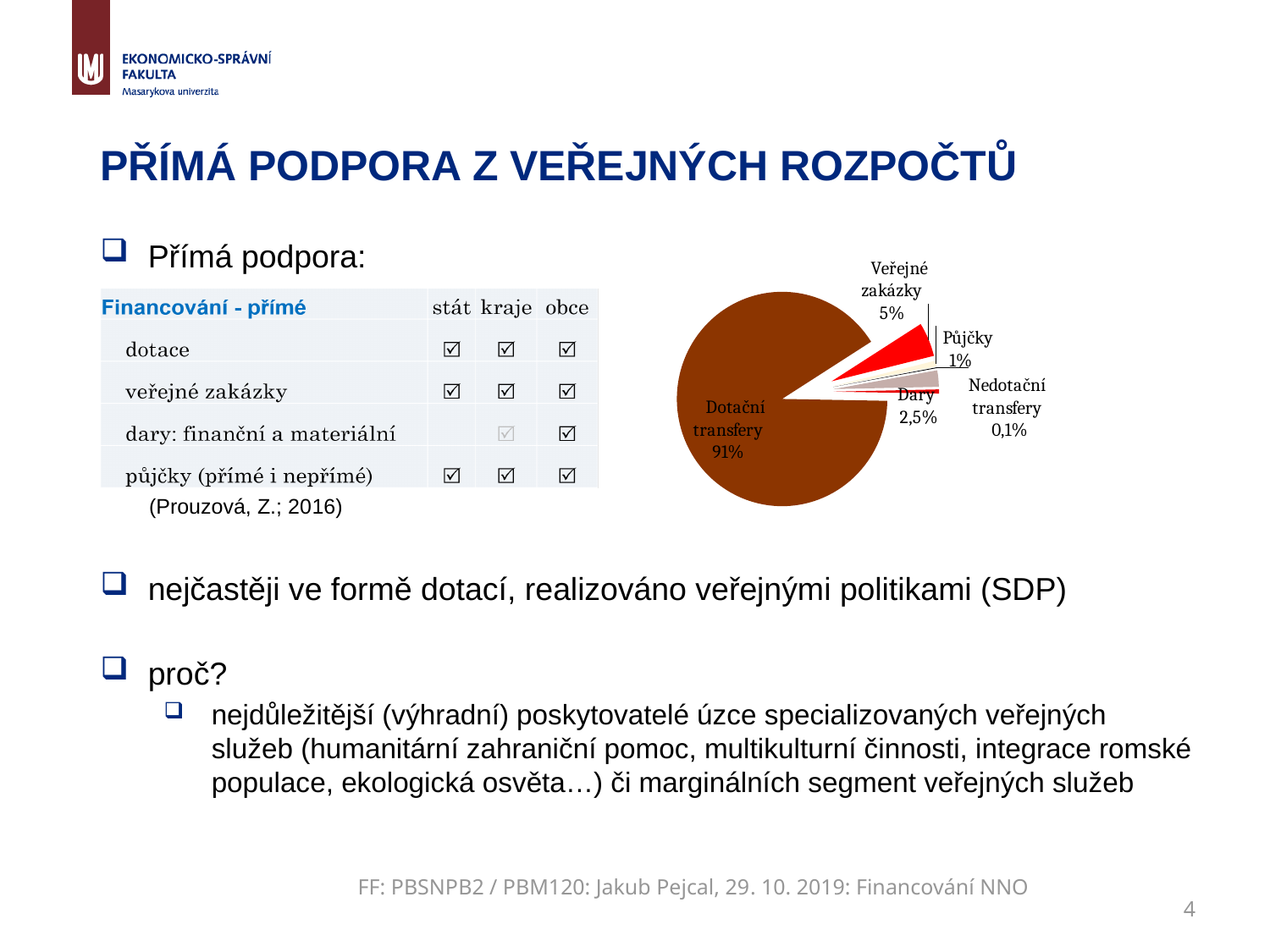
What share of the pie does Veřejné zakázky have? 5% What is the value shown for Půjčky in the pie chart? 1% What is the value shown for Nedotační transfery in the pie chart? 0,1% How many slices does the pie chart have? 6 Which slice of the pie chart is the smallest? Nedotační transfery What colour is the Dotační transfery slice in the pie chart? brown Which slice of the pie chart is the largest? Dotační transfery What is the value shown for Dary in the pie chart? 2,5% What kind of chart is shown on the slide? pie chart What share of the pie does Dotační transfery have? 91% Which is larger in the pie chart, Veřejné zakázky or Dary? Veřejné zakázky What is the difference in percentage points between Dotační transfery and Veřejné zakázky? 86